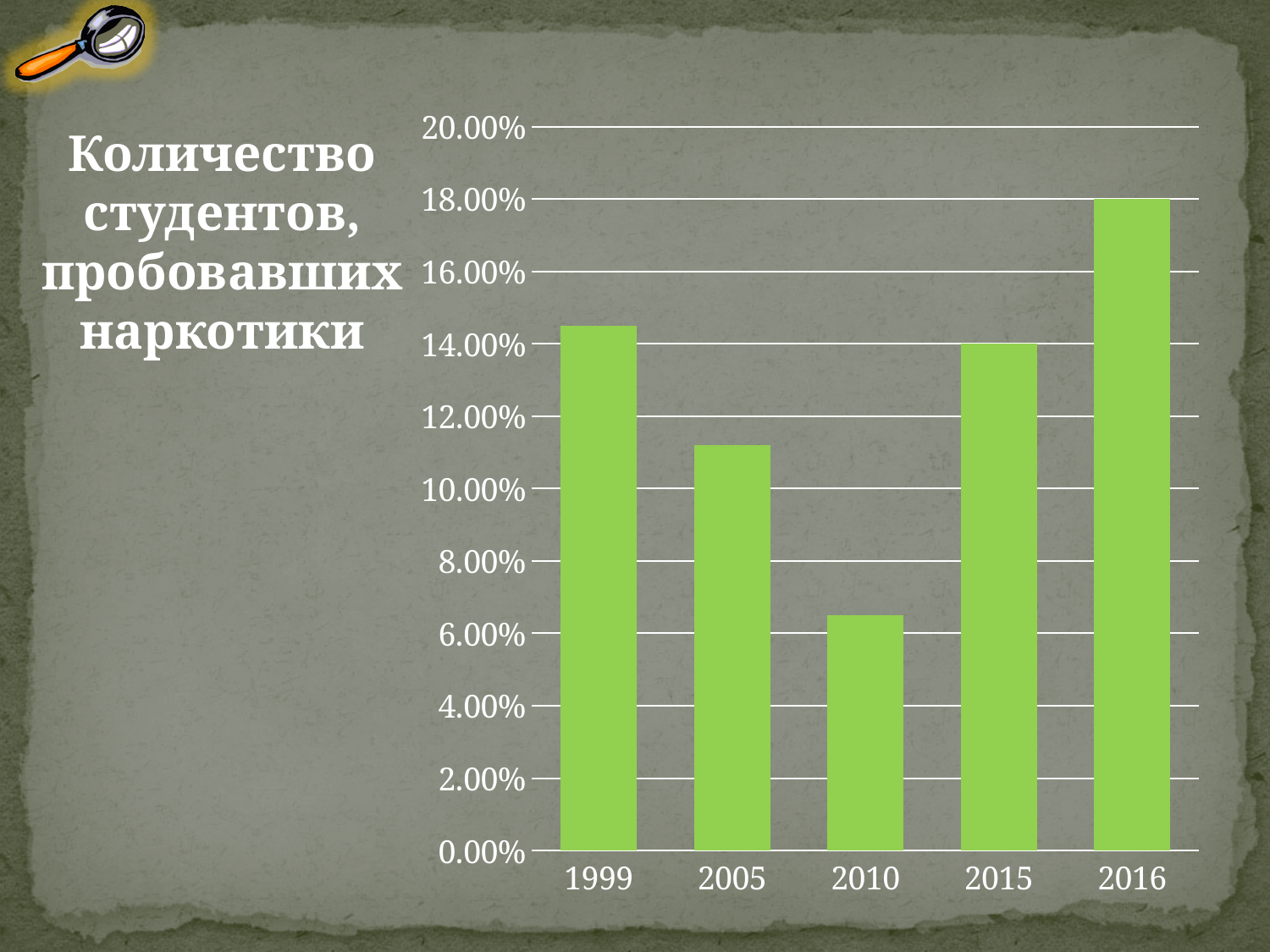
Is the value for 1999 greater or less than 12.00%? greater Which is larger, the value for 2010 or the value for 2015? 2015 Which is larger, the value for 1999 or the value for 2005? 1999 Do the values rise or fall from 2010 to 2016? rise What is the title shown next to the chart? Количество студентов, пробовавших наркотики How many years are shown on the x axis of the chart? 5 Is the value for 2010 greater or less than 8.00%? less Which year has the highest value in the chart? 2016 Is the value for 2005 greater or less than 10.00%? greater Which year has the lowest value in the chart? 2010 What kind of chart is shown on the slide? bar chart